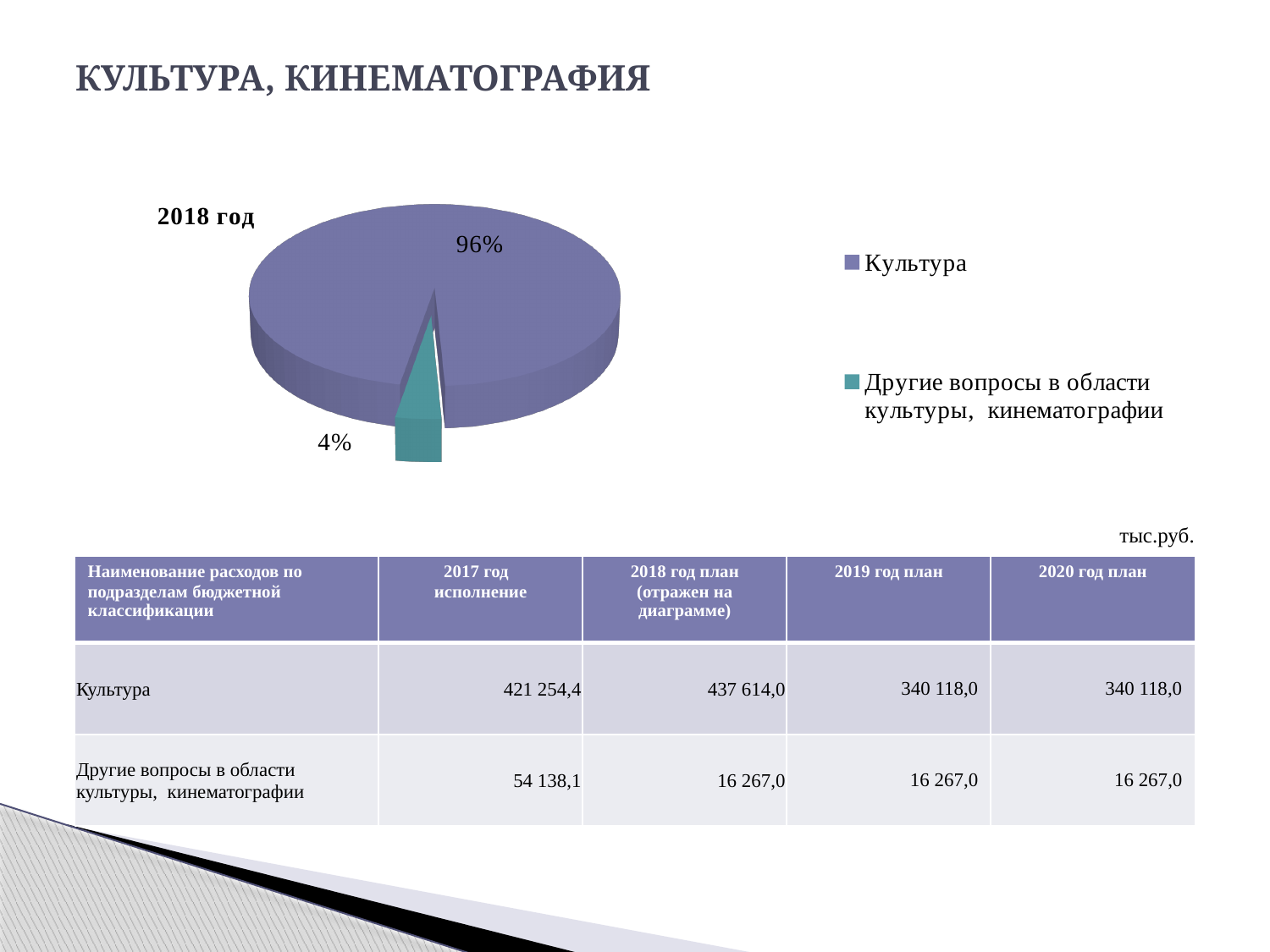
What colour is the slice for Другие вопросы в области культуры, кинематографии? teal How many slices does the pie chart have? 2 By how many percentage points does the Культура share exceed the Другие вопросы в области культуры, кинематографии share? 92 Is the share for Культура greater or less than 50%? greater What is the title of the pie chart? 2018 год Which is larger: the share for Культура or the share for Другие вопросы в области культуры, кинематографии? Культура What share of the pie does Культура take? 96% What share of the pie does Другие вопросы в области культуры, кинематографии take? 4% Which category has the smallest slice of the pie? Другие вопросы в области культуры, кинематографии Which category has the largest slice of the pie? Культура What kind of chart is shown on the slide? pie chart How many entries does the legend list? 2